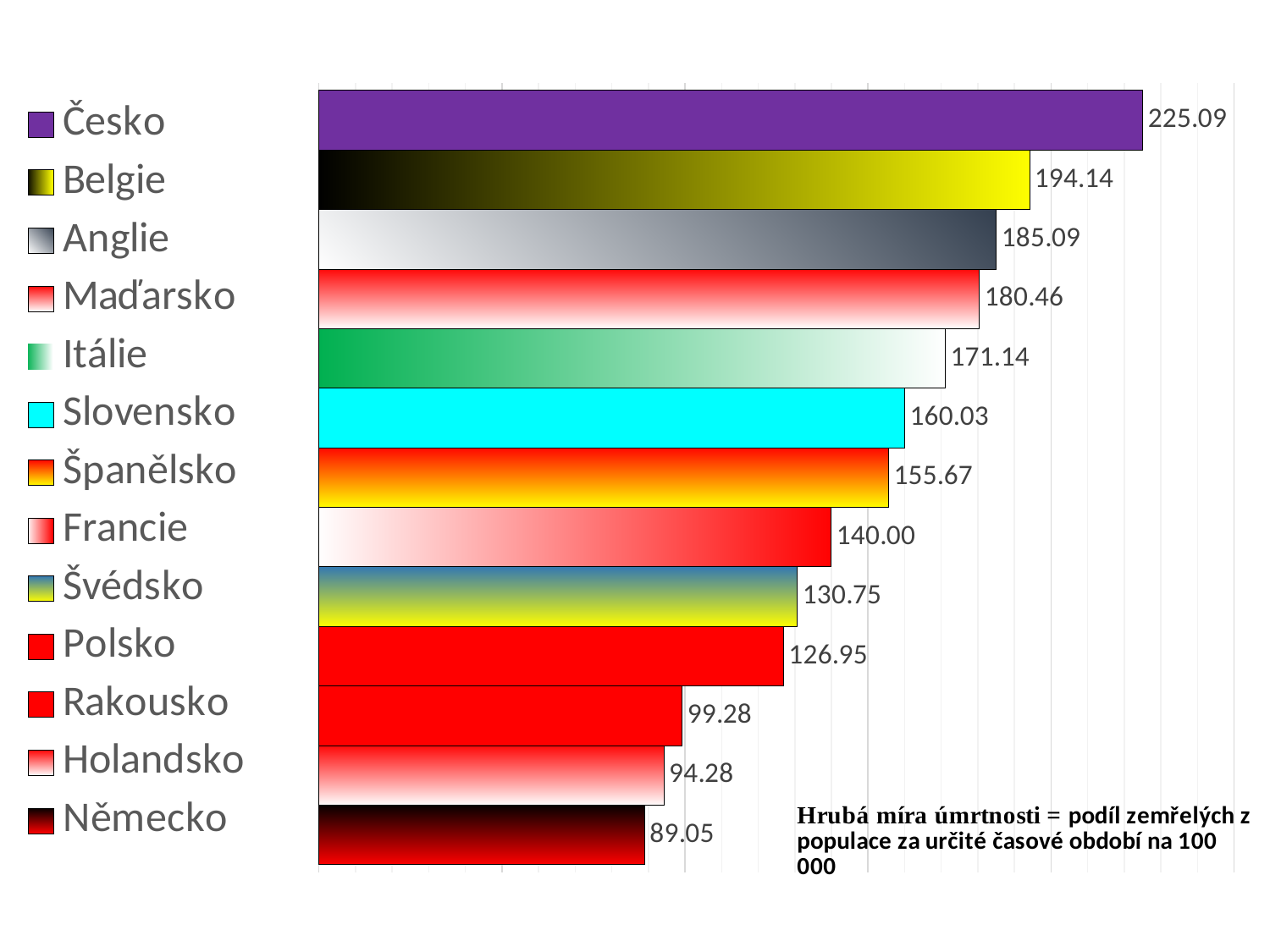
Which country has the lowest value? Německo Which country has the highest value? Česko What kind of chart is shown on the slide? Bar chart What is the difference between the values for Francie and Polsko? 13.05 What is the difference between the values for Belgie and Anglie? 9.05 Which is larger, the value for Maďarsko or the value for Itálie? Maďarsko What is the value for Německo? 89.05 What is the value for Slovensko? 160.03 How many countries are shown in the chart? 13 Which country is listed first in the legend? Česko Which is larger, the value for Rakousko or the value for Holandsko? Rakousko What is the value for Česko? 225.09